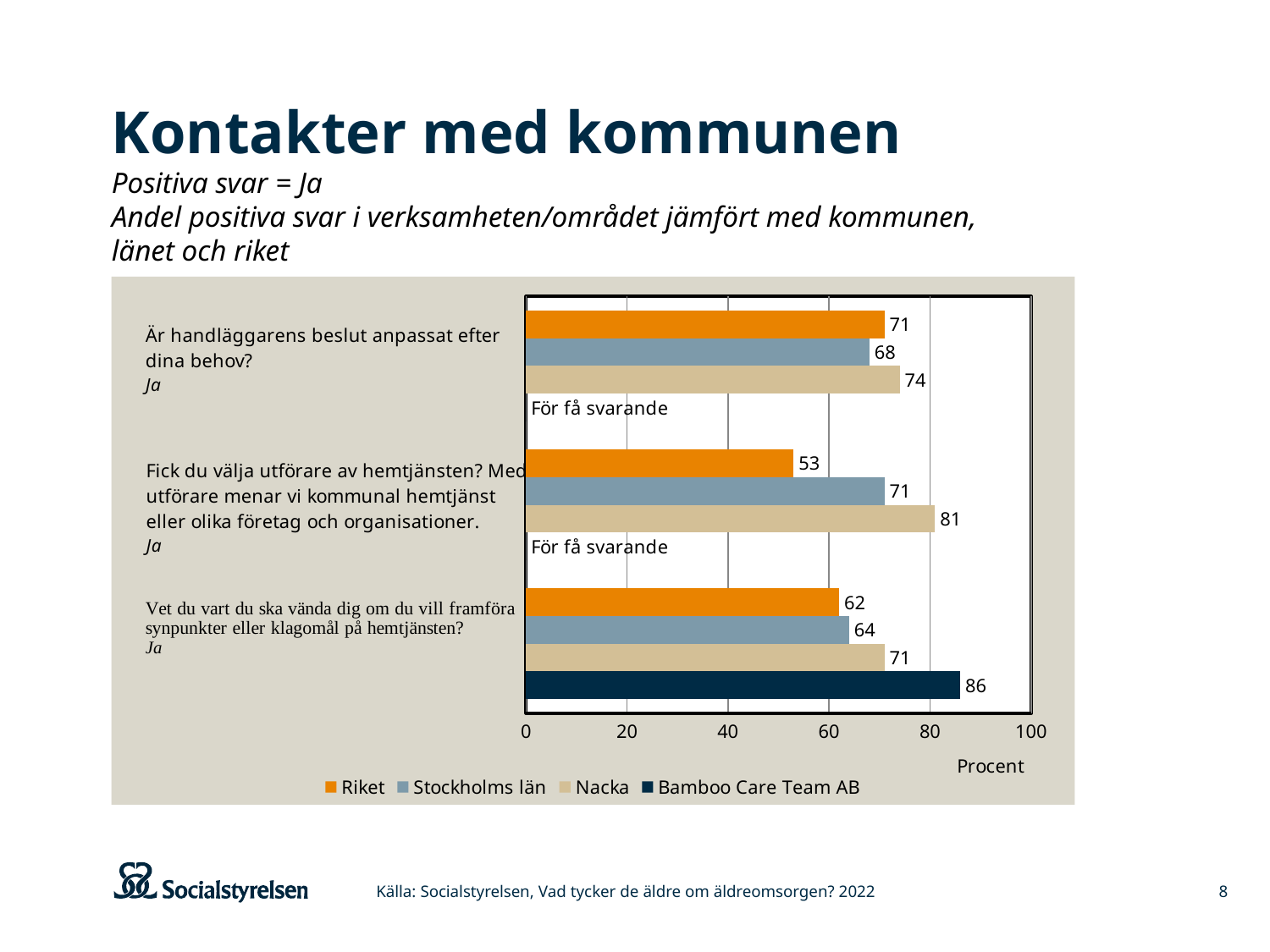
How many series does the legend list? 4 What is the value for Nacka on the question "Fick du välja utförare av hemtjänsten?"? 81 What kind of chart is shown on the slide? bar chart What is the label of the x axis? Procent What is the value for Bamboo Care Team AB on the question "Vet du vart du ska vända dig om du vill framföra synpunkter eller klagomål på hemtjänsten?"? 86 On the question "Är handläggarens beslut anpassat efter dina behov?", which is larger: Nacka or Stockholms län? Nacka What is the difference between Nacka and Riket on the question "Fick du välja utförare av hemtjänsten?"? 28 What is the value for Riket on the question "Är handläggarens beslut anpassat efter dina behov?"? 71 Which series has the lowest value on the question "Fick du välja utförare av hemtjänsten?"? Riket Which series has the highest value on the question "Vet du vart du ska vända dig om du vill framföra synpunkter eller klagomål på hemtjänsten?"? Bamboo Care Team AB How many survey questions (categories) are shown on the chart? 3 What is shown for Bamboo Care Team AB on the question "Fick du välja utförare av hemtjänsten?"? För få svarande